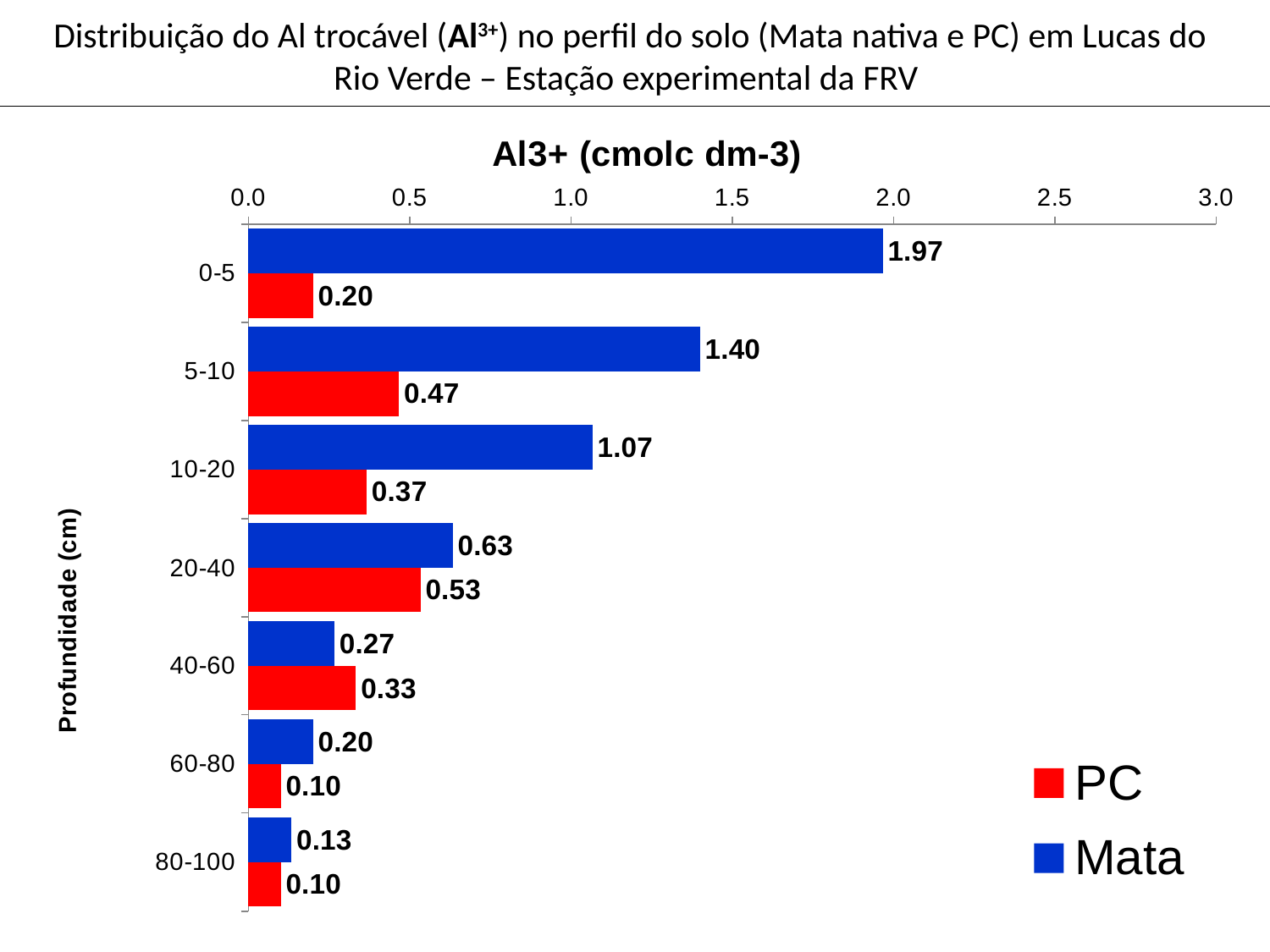
How many series does the legend list? 2 Which depth has the highest Mata value? 0-5 What is the PC value for the 20-40 cm depth? 0.53 Is the Mata value for the 10-20 cm depth greater or less than 1.0? greater At the 40-60 cm depth, which series has the larger value, PC or Mata? PC What is the Mata value for the 0-5 cm depth? 1.97 What is the PC value for the 5-10 cm depth? 0.47 Which depth has the lowest PC value? 60-80 and 80-100 What is the difference between the Mata and PC values at the 0-5 cm depth? 1.77 How many depth categories are shown on the chart? 7 What is the title of the chart? Al3+ (cmolc dm-3) What kind of chart is shown on the slide? bar chart